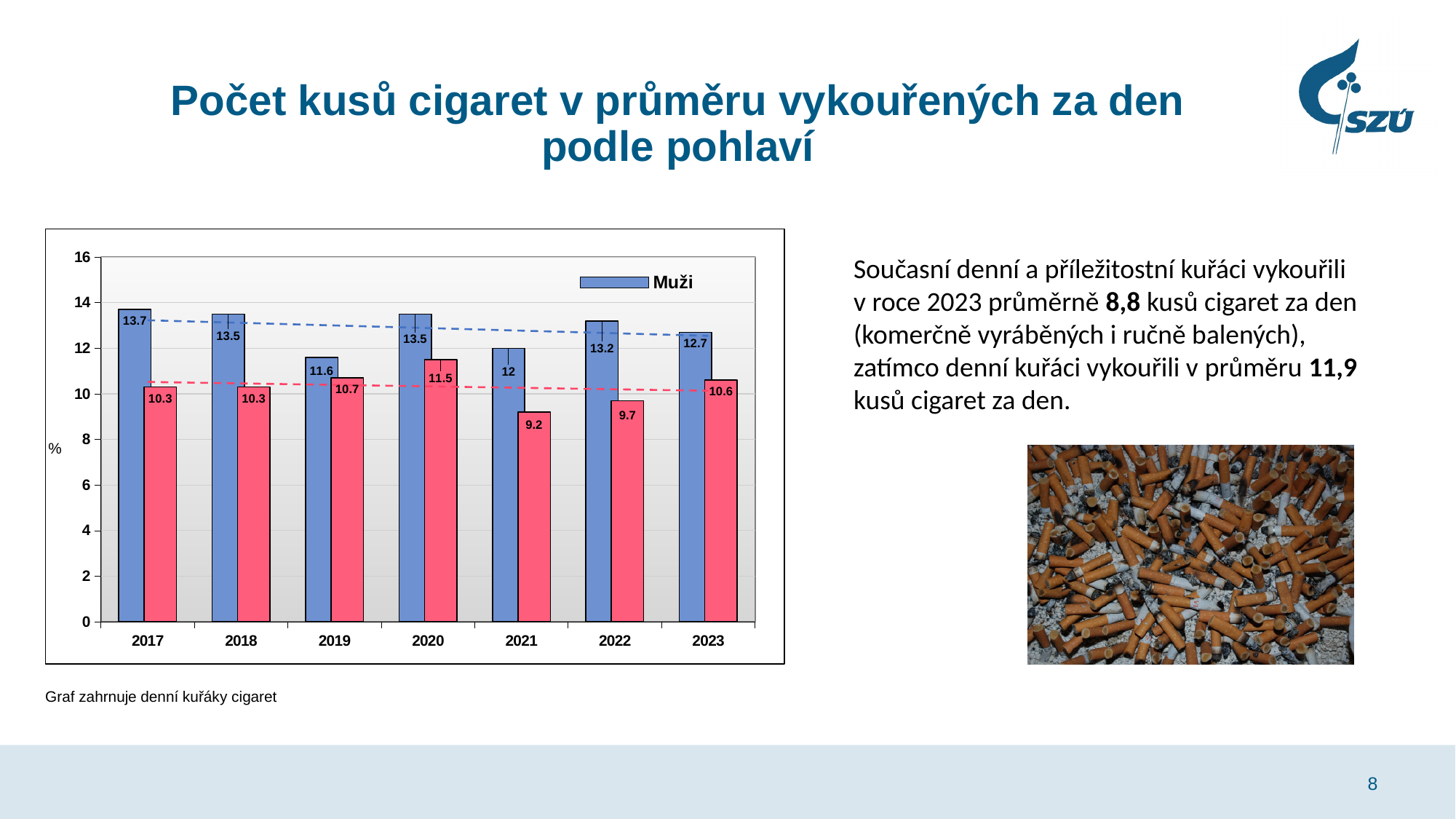
Which is larger in 2019: the Muži value or the red bar value? Muži Which series name is listed in the chart legend? Muži Is the Muži value for 2023 greater or less than 12? greater What is the value for Muži in 2017? 13.7 What is the value for Muži in 2021? 12 What is the value of the red bar in 2023? 10.6 In which year is the red bar lowest? 2021 How many years are shown on the x axis? 7 What kind of chart is shown on the slide? bar chart In which year is the Muži value highest? 2017 What is the difference between the Muži value and the red bar value in 2022? 3.5 What is the value of the red bar in 2020? 11.5